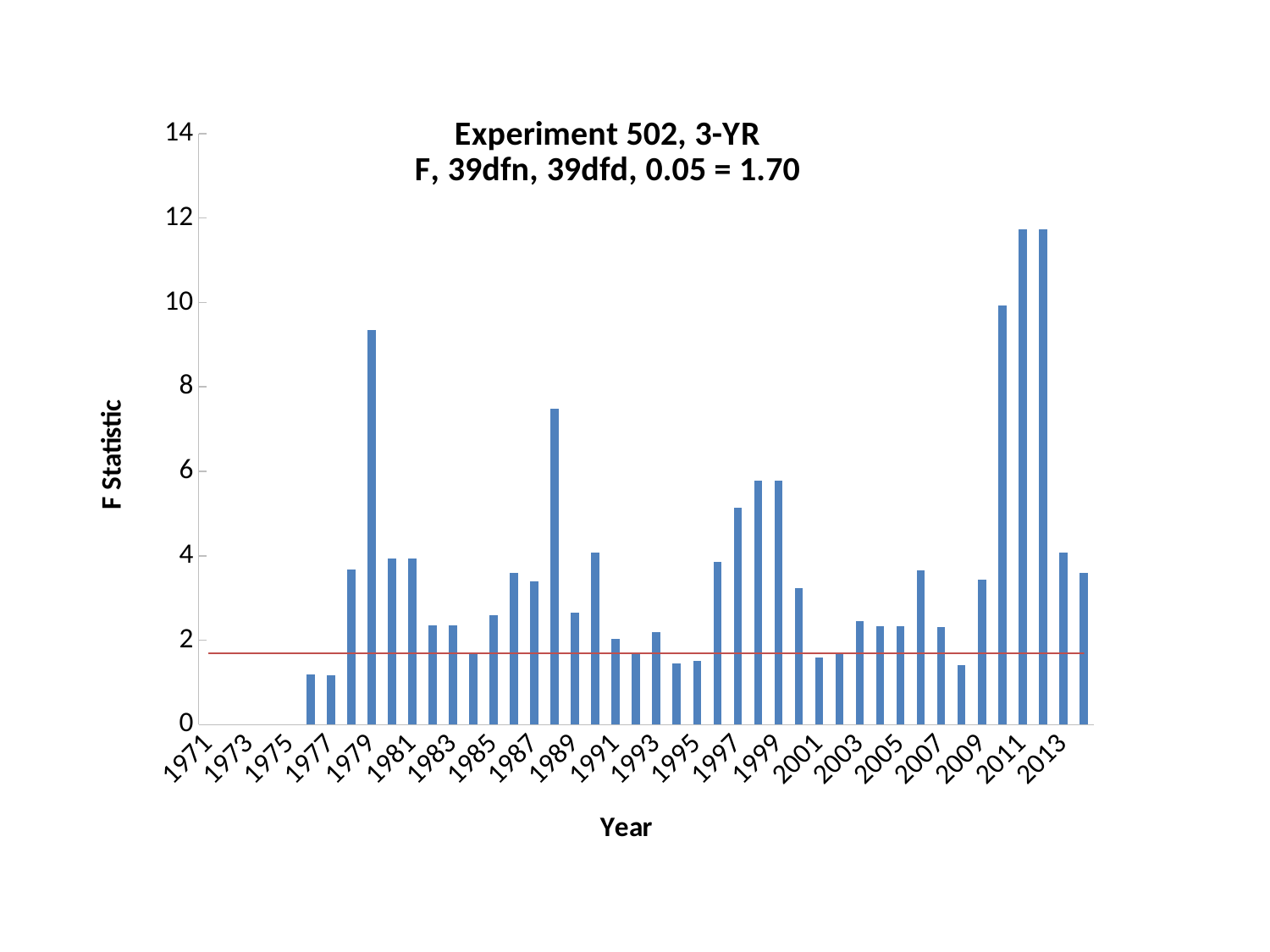
Which year has the larger F statistic, 2011 or 2013? 2011 Is the F statistic for 1979 greater or less than 8? greater Which year has the larger F statistic, 1977 or 1981? 1981 What is the title of the chart? Experiment 502, 3-YR F, 39dfn, 39dfd, 0.05 = 1.70 Is the F statistic for 2013 greater or less than 6? less Is the F statistic for 2011 greater or less than 10? greater What kind of chart is shown on the slide? Bar chart What is the label of the vertical axis? F Statistic Which year has the larger F statistic, 1979 or 1989? 1979